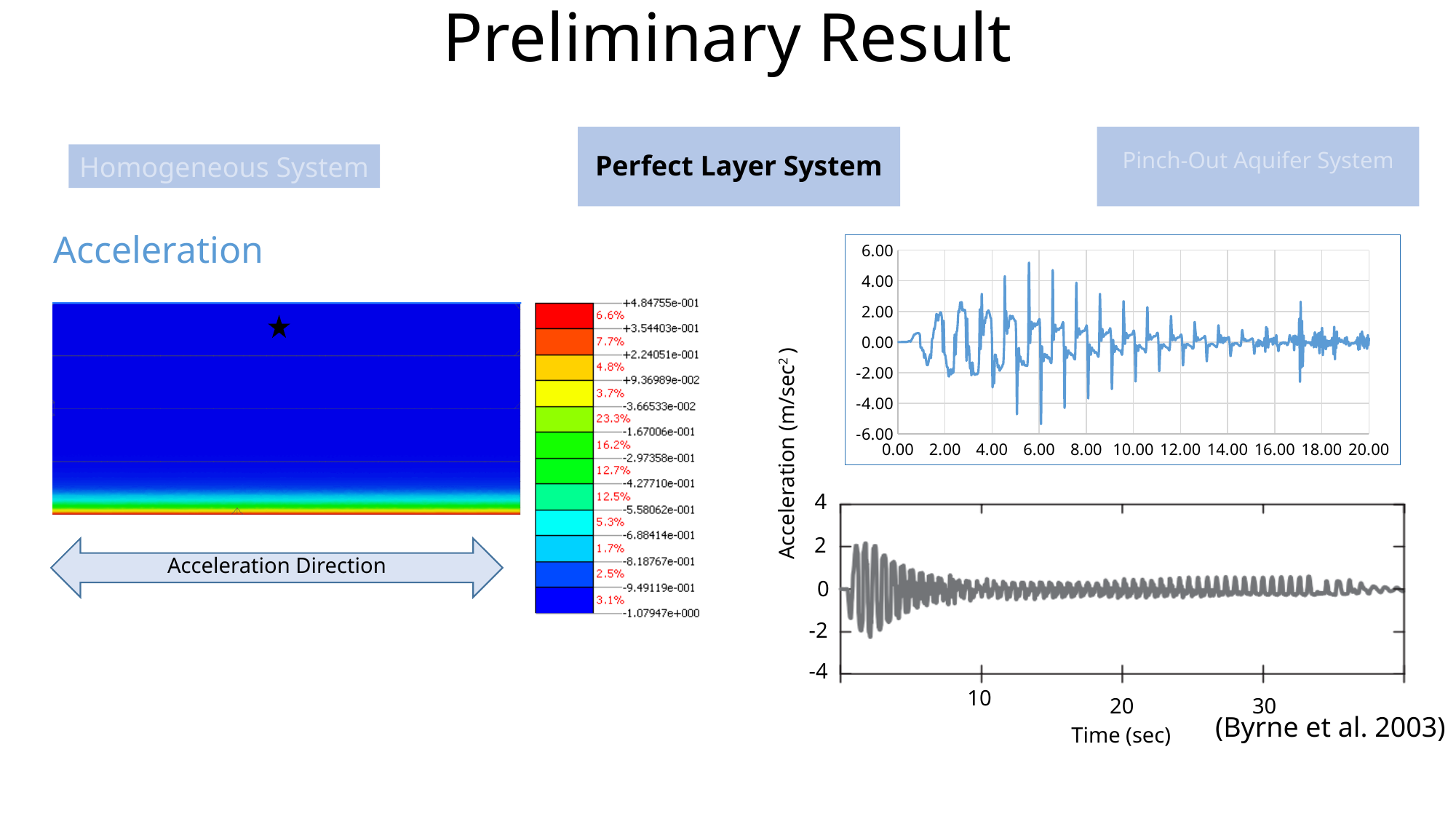
In the colour legend next to the contour plot, which percentage is the smallest? 1.7% In the upper right chart, is the lowest (most negative) value of the acceleration greater or less than -4.00? less What kind of chart is the upper chart on the right (blue line, time 0.00 to 20.00)? line chart In the lower right chart (Byrne et al. 2003), what are the minimum and maximum tick values on the vertical axis? -4 and 4 In the lower right chart (Byrne et al. 2003), what is the label of the horizontal axis? Time (sec) What is the label of the vertical axis shared by the two charts on the right? Acceleration (m/sec²) In the upper right chart, does the amplitude of the oscillations grow or decay between 6.00 and 20.00 seconds? decay In the lower right chart (Byrne et al. 2003), does the amplitude of the oscillations increase or decrease after the first few seconds? decrease In the colour legend next to the contour plot, which percentage is the largest? 23.3% In the upper right chart, is the largest positive peak of the acceleration greater or less than 4.00? greater